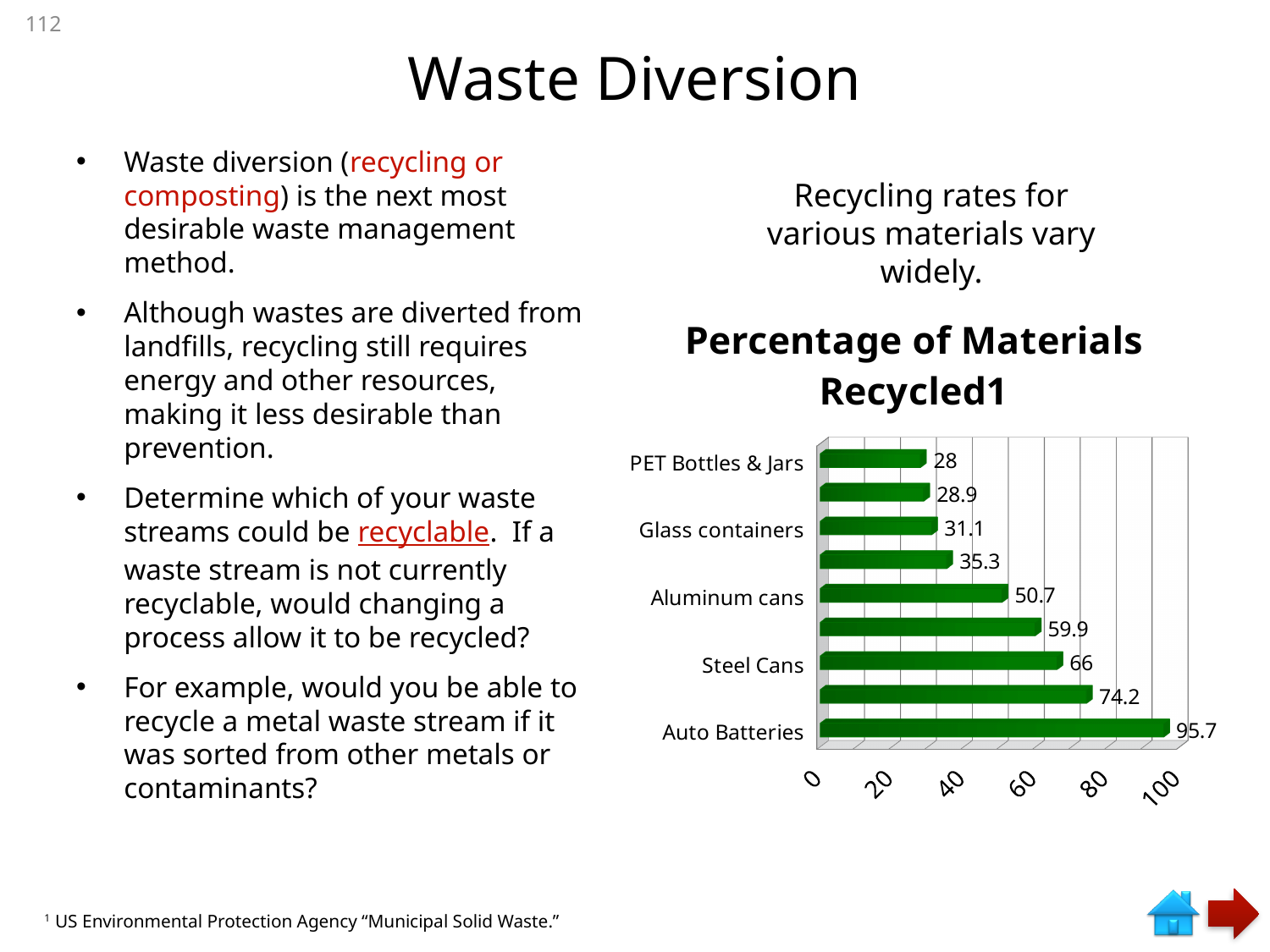
What is the difference between the values for Auto Batteries and Steel Cans in the Percentage of Materials Recycled chart? 29.7 Is the value for Steel Cans in the Percentage of Materials Recycled chart greater or less than 60? greater What is the value for Aluminum cans in the Percentage of Materials Recycled chart? 50.7 Which labeled category has the highest value in the Percentage of Materials Recycled chart? Auto Batteries What kind of chart is the Percentage of Materials Recycled chart? Bar chart How many bars are plotted in the Percentage of Materials Recycled chart? 9 What is the value for Glass containers in the Percentage of Materials Recycled chart? 31.1 What is the value for Auto Batteries in the Percentage of Materials Recycled chart? 95.7 What is the value for PET Bottles & Jars in the Percentage of Materials Recycled chart? 28 What is the value for Steel Cans in the Percentage of Materials Recycled chart? 66 Which labeled category has the lowest value in the Percentage of Materials Recycled chart? PET Bottles & Jars Which is larger in the Percentage of Materials Recycled chart, Aluminum cans or Glass containers? Aluminum cans